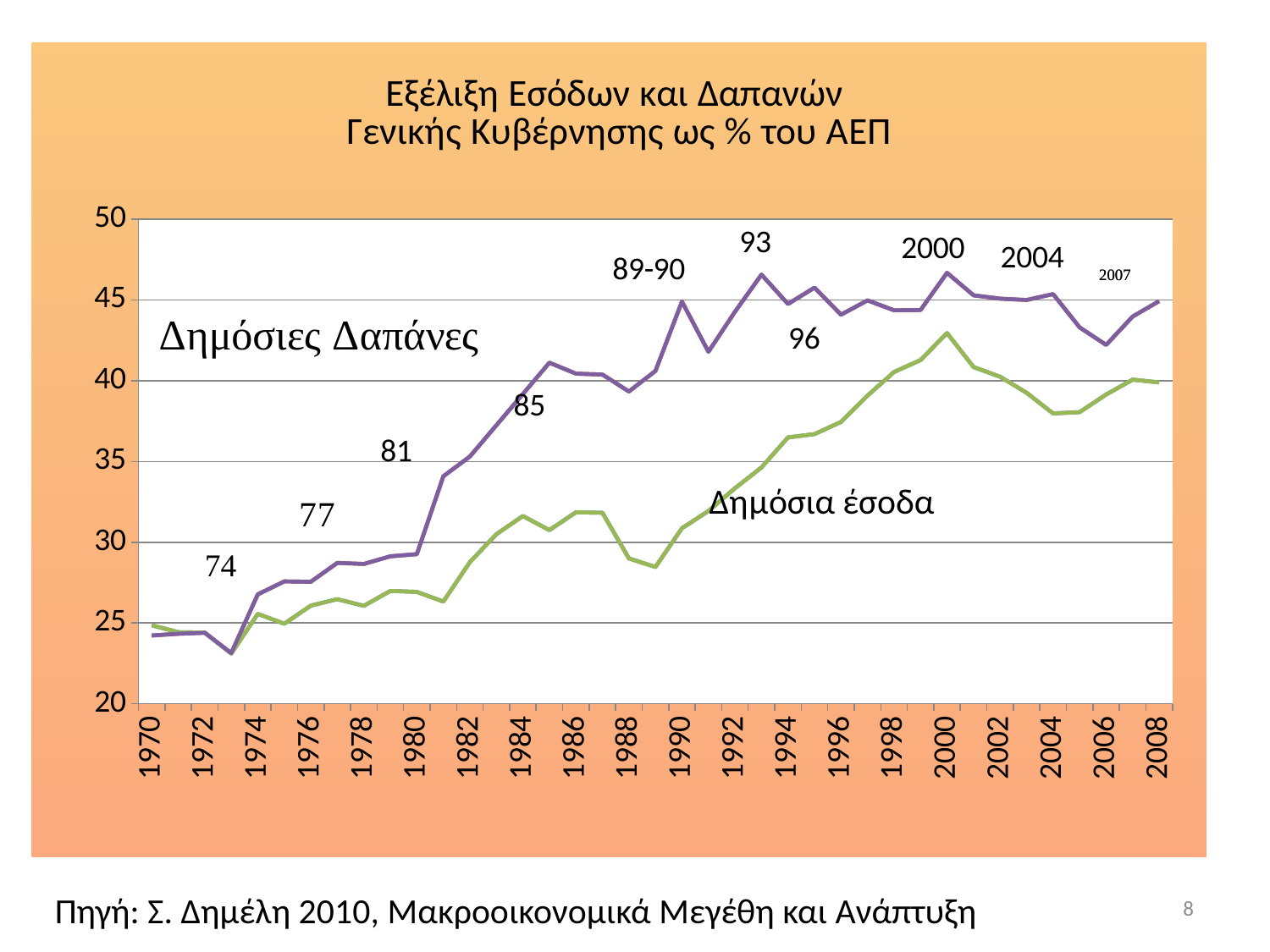
What is the title of the chart? Εξέλιξη Εσόδων και Δαπανών Γενικής Κυβέρνησης ως % του ΑΕΠ Is the value for Δημόσια έσοδα in 2004 greater or less than 40? less Overall, do the values for Δημόσιες Δαπάνες rise or fall from 1970 to 2008? rise Is the value for Δημόσια έσοδα in 1980 greater or less than 30? less What kind of chart is shown on the slide? line chart What are the names of the two series plotted on the chart? Δημόσιες Δαπάνες and Δημόσια έσοδα Is the value for Δημόσιες Δαπάνες in 1970 greater or less than 25? less In 2008, which series has the higher value, Δημόσιες Δαπάνες or Δημόσια έσοδα? Δημόσιες Δαπάνες In which year does Δημόσια έσοδα reach its highest value? 2000 How many data series are plotted on the chart? 2